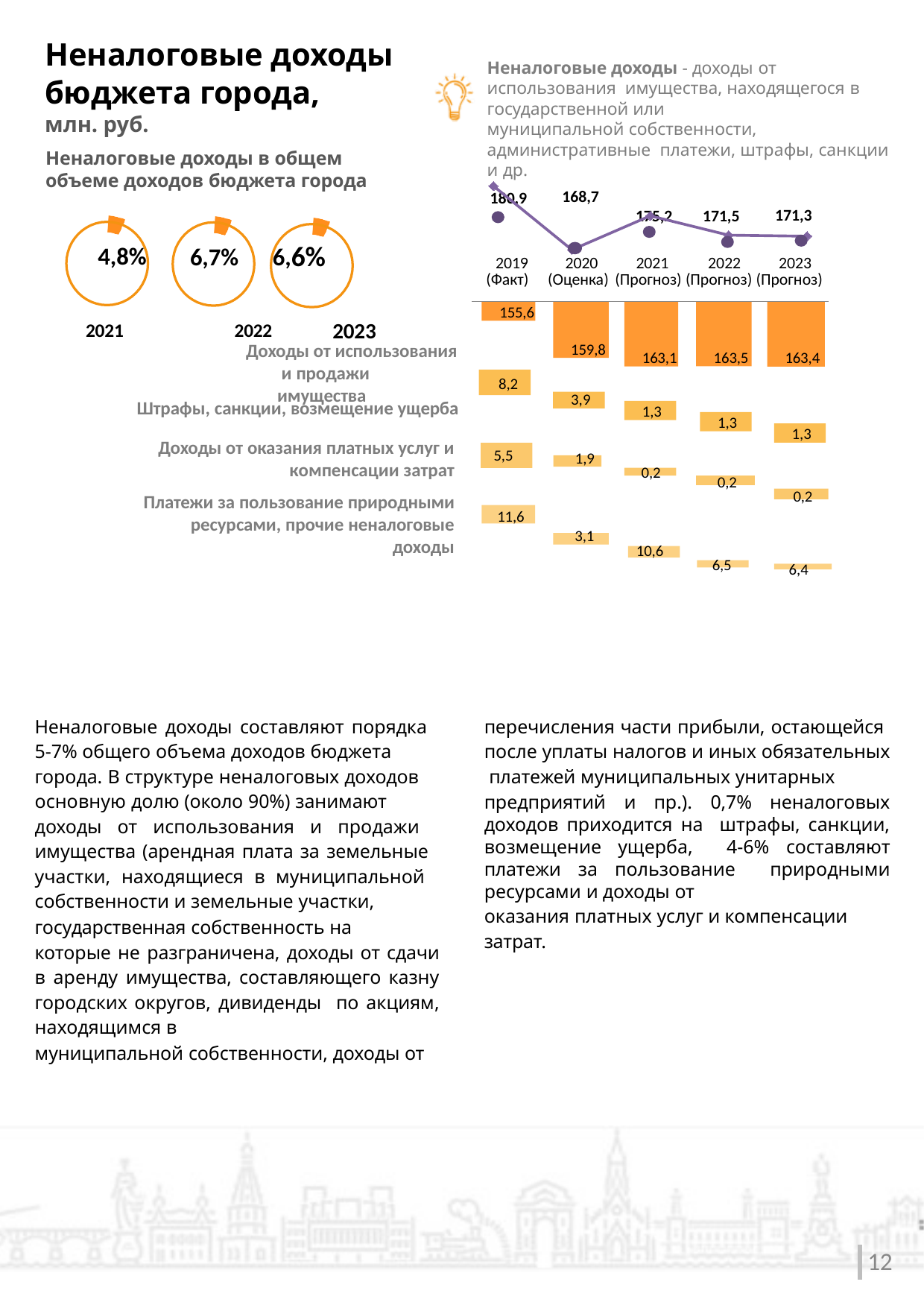
On the bar chart breakdown, which is larger for 2020: 'Штрафы, санкции, возмещение ущерба' or 'Доходы от оказания платных услуг и компенсации затрат'? Штрафы, санкции, возмещение ущерба On the line chart of non-tax revenues, how many years are plotted? 5 On the bar chart breakdown, what is the value of 'Платежи за пользование природными ресурсами, прочие неналоговые доходы' for 2021? 10,6 On the bar chart breakdown, what is the value of 'Доходы от использования и продажи имущества' for 2022? 163,5 On the bar chart breakdown, what is the value of 'Штрафы, санкции, возмещение ущерба' for 2019? 8,2 On the line chart of non-tax revenues (Неналоговые доходы бюджета города), what is the value for 2019 (Факт)? 180,9 On the line chart of non-tax revenues, what is the value for 2020 (Оценка)? 168,7 On the bar chart breakdown, in which year is 'Доходы от использования и продажи имущества' the lowest? 2019 In the ring indicators 'Неналоговые доходы в общем объеме доходов бюджета города', what is the share shown for 2022? 6,7% On the line chart of non-tax revenues, which year has the highest value? 2019 (Факт) On the line chart of non-tax revenues, which year has the lowest value? 2020 (Оценка) On the line chart of non-tax revenues, what is the difference between the 2019 value and the 2020 value? 12,2